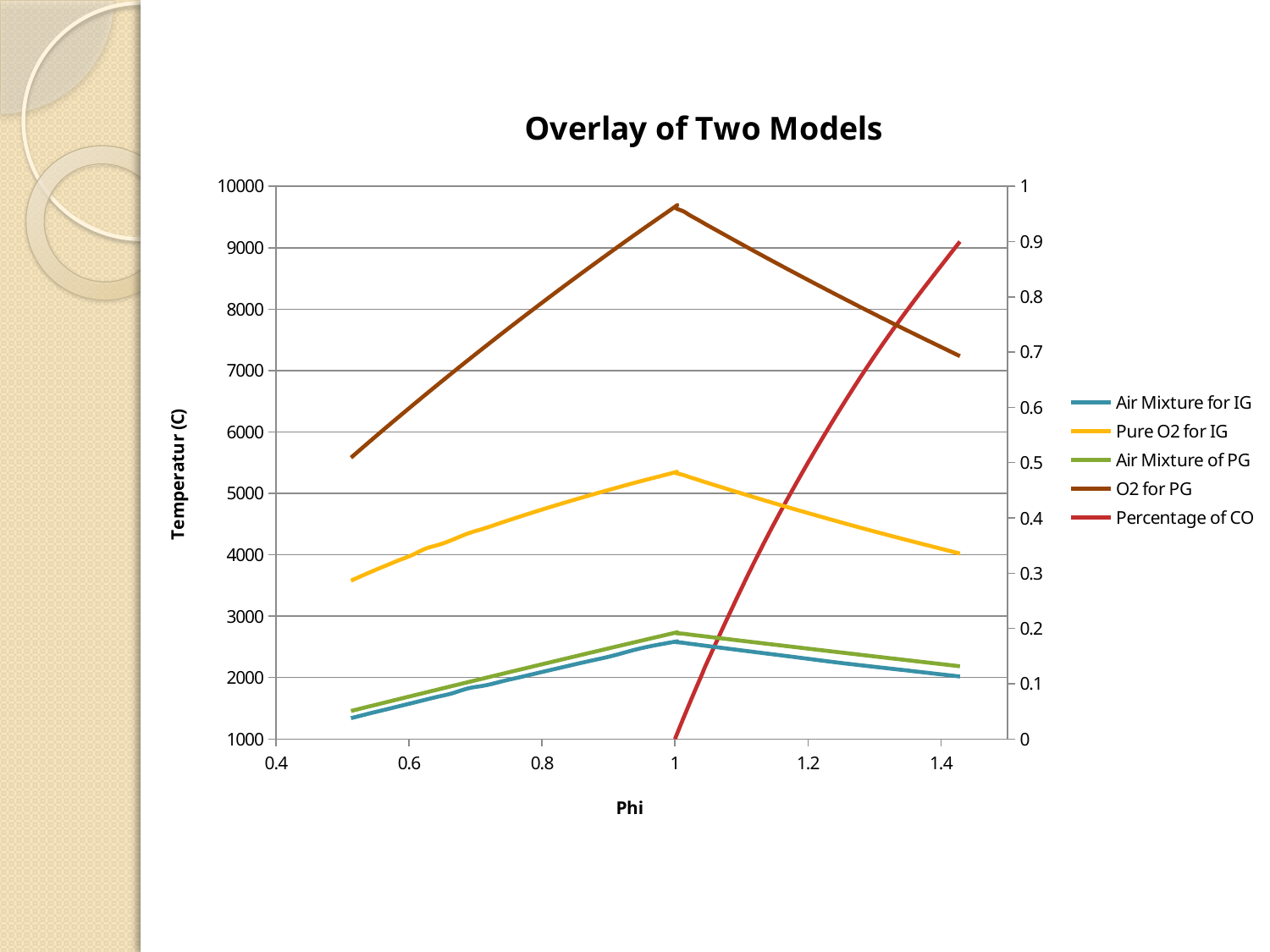
At Phi = 1, which is larger: Pure O2 for IG or Air Mixture of PG? Pure O2 for IG Is the value for Percentage of CO at Phi = 1.4 greater or less than 0.8 on the right-hand axis? greater Is the value for Air Mixture for IG at Phi = 1 greater or less than 3000? less Is the value for O2 for PG at Phi = 1 greater or less than 9000? greater What type of chart is shown on the slide? Line chart How many series does the legend list? 5 What is the label of the x axis? Phi Which series has the lowest temperature values on the chart? Air Mixture for IG What is the title of the chart? Overlay of Two Models Does the Percentage of CO series rise or fall as Phi increases from 1 to 1.4? Rise Which series reaches the highest temperature on the chart? O2 for PG